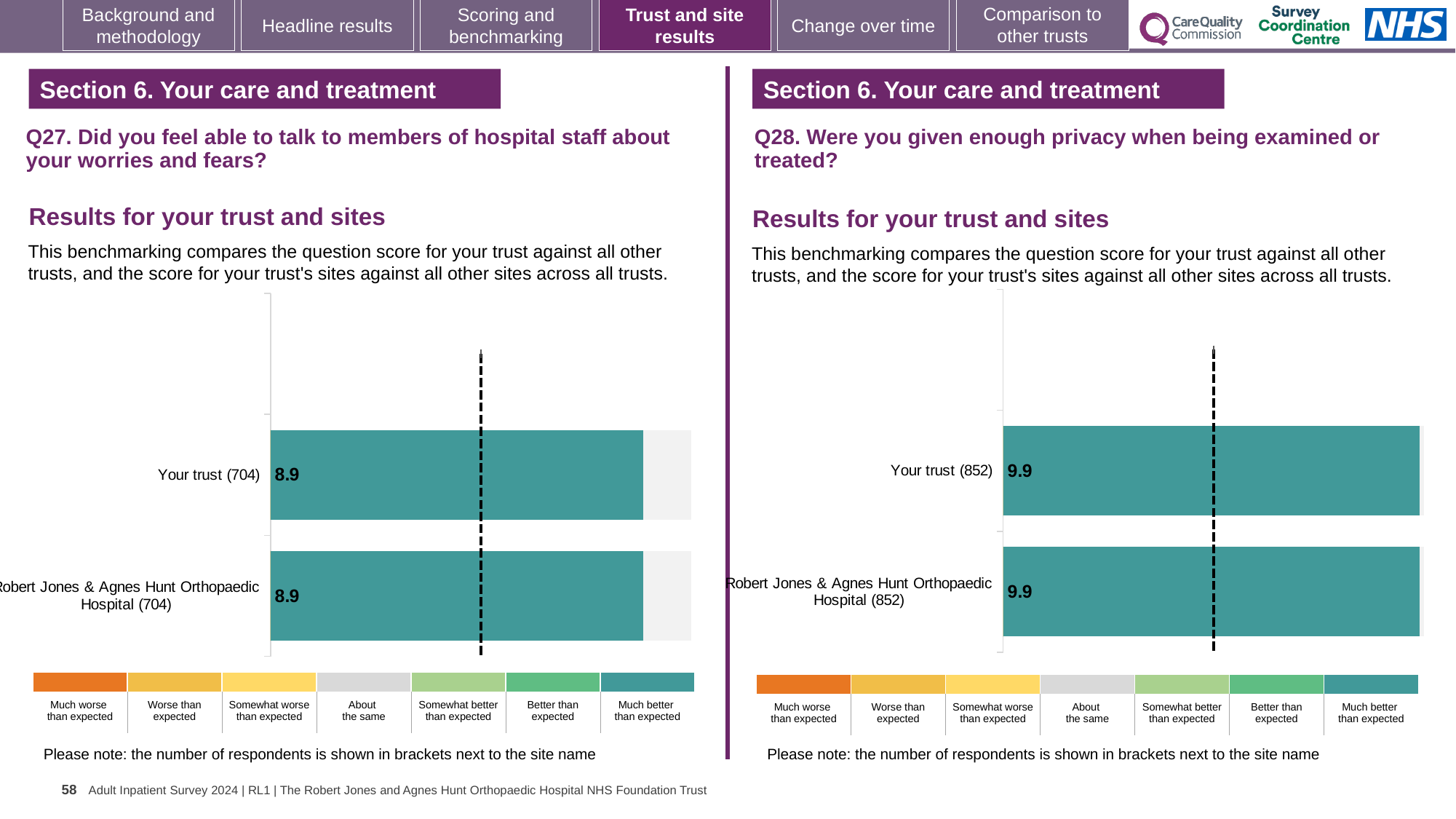
On the Q28 chart (right), what is the difference between the score for Your trust and the score for Robert Jones & Agnes Hunt Orthopaedic Hospital? 0 What kind of chart is the Q28 chart (right)? Bar chart On the Q27 chart (left), what is the difference between the score for Your trust and the score for Robert Jones & Agnes Hunt Orthopaedic Hospital? 0 On the Q27 chart (left), what is the score for Your trust? 8.9 How many categories does the colour key below the Q27 chart (left) list? 7 On the Q28 chart (right), what is the score for Your trust? 9.9 On the Q28 chart (right), how many respondents are shown in brackets next to Robert Jones & Agnes Hunt Orthopaedic Hospital? 852 On the Q27 chart (left), what is the score for Robert Jones & Agnes Hunt Orthopaedic Hospital? 8.9 How many bars are plotted on the Q27 chart (left)? 2 On the Q27 chart (left), how many respondents are shown in brackets next to Your trust? 704 On the Q28 chart (right), what is the score for Robert Jones & Agnes Hunt Orthopaedic Hospital? 9.9 How many bars are plotted on the Q28 chart (right)? 2